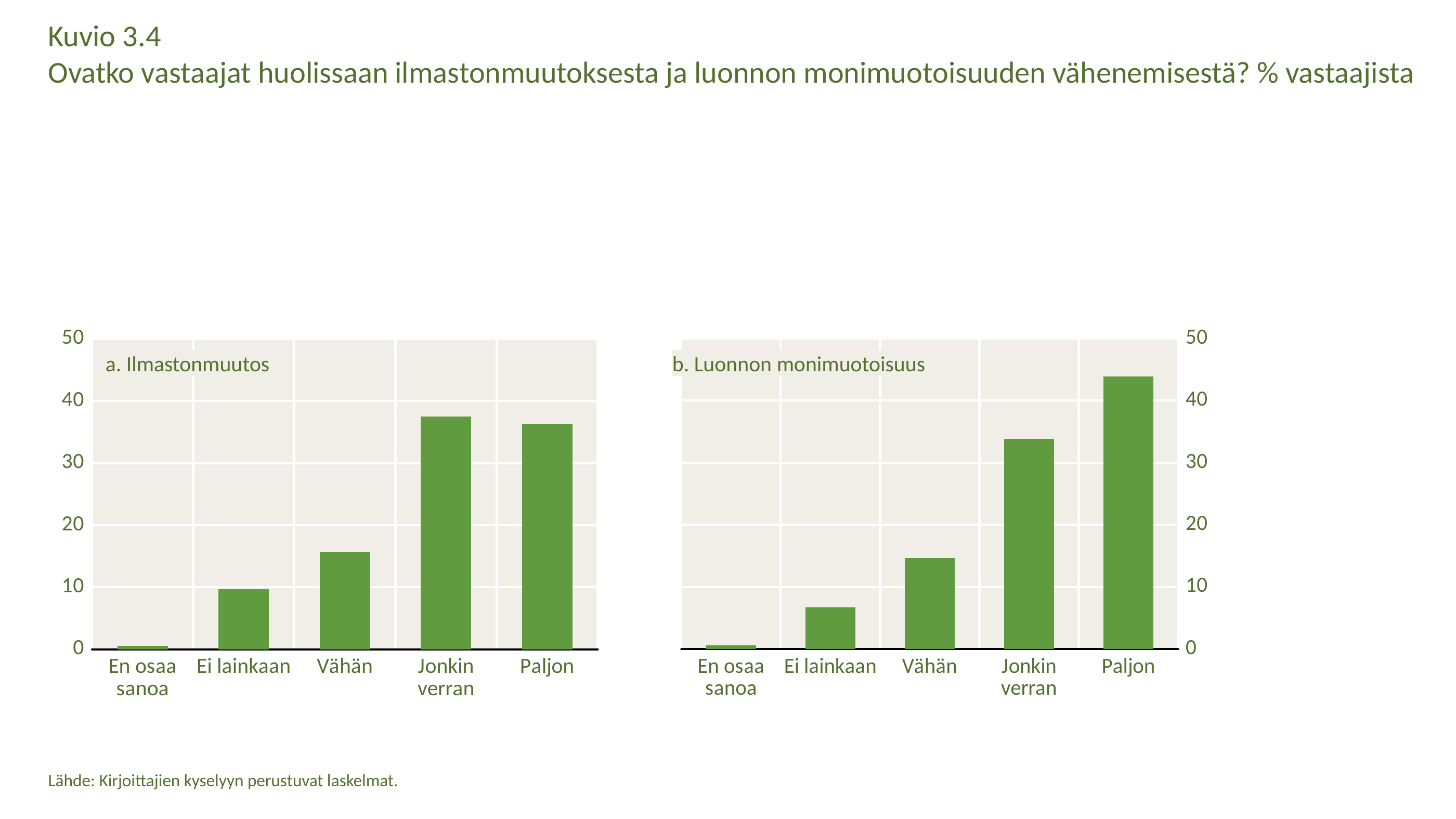
In the "b. Luonnon monimuotoisuus" chart, which is larger, the value for Paljon or the value for Jonkin verran? Paljon In the "b. Luonnon monimuotoisuus" chart, is the value for Paljon greater or less than 40? greater How many categories are shown on the x axis of the "b. Luonnon monimuotoisuus" chart? 5 In the "a. Ilmastonmuutos" chart, which category has the lowest value? En osaa sanoa What kind of chart is "a. Ilmastonmuutos"? bar chart Which is larger, the value for Paljon in the "b. Luonnon monimuotoisuus" chart or the value for Paljon in the "a. Ilmastonmuutos" chart? b. Luonnon monimuotoisuus In the "b. Luonnon monimuotoisuus" chart, is the value for Ei lainkaan greater or less than 10? less In the "a. Ilmastonmuutos" chart, is the value for Jonkin verran greater or less than 30? greater In the "b. Luonnon monimuotoisuus" chart, which category has the highest value? Paljon In the "b. Luonnon monimuotoisuus" chart, which category has the lowest value? En osaa sanoa In the "b. Luonnon monimuotoisuus" chart, do the values rise or fall from En osaa sanoa to Paljon along the x axis? rise